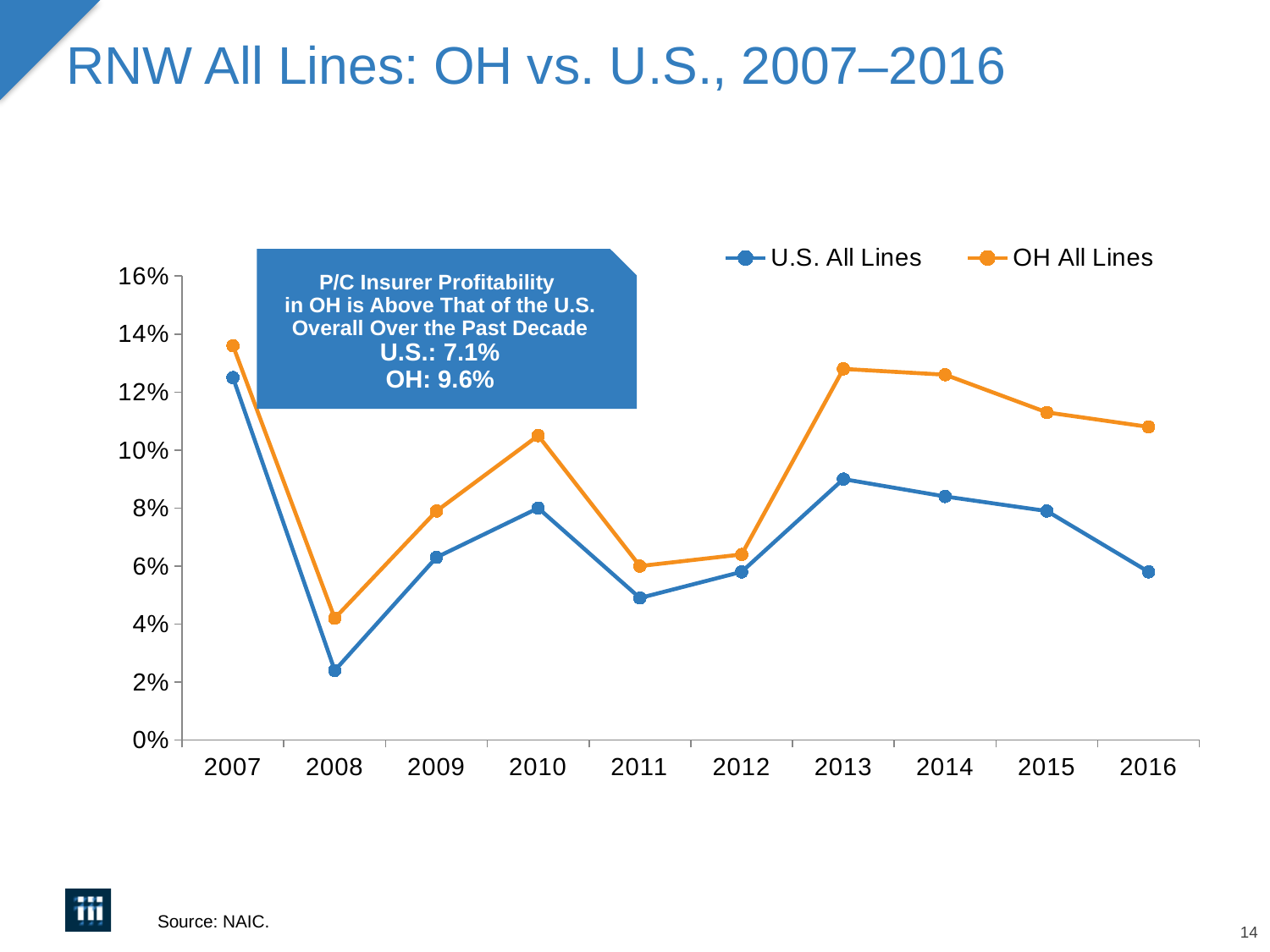
In which year is the U.S. All Lines value lowest? 2008 In which year is the OH All Lines value highest? 2007 What kind of chart is shown on the slide? line chart In which year is the OH All Lines value lowest? 2008 Is the U.S. All Lines value for 2016 greater or less than 8%? less Do the U.S. All Lines values rise or fall from 2013 to 2016? fall Is the OH All Lines value for 2013 greater or less than 12%? greater How many series does the legend list? 2 Which series has the larger value in 2014, U.S. All Lines or OH All Lines? OH All Lines Is the OH All Lines value for 2008 greater or less than 6%? less How many years are plotted along the x axis? 10 In which year is the U.S. All Lines value highest? 2007